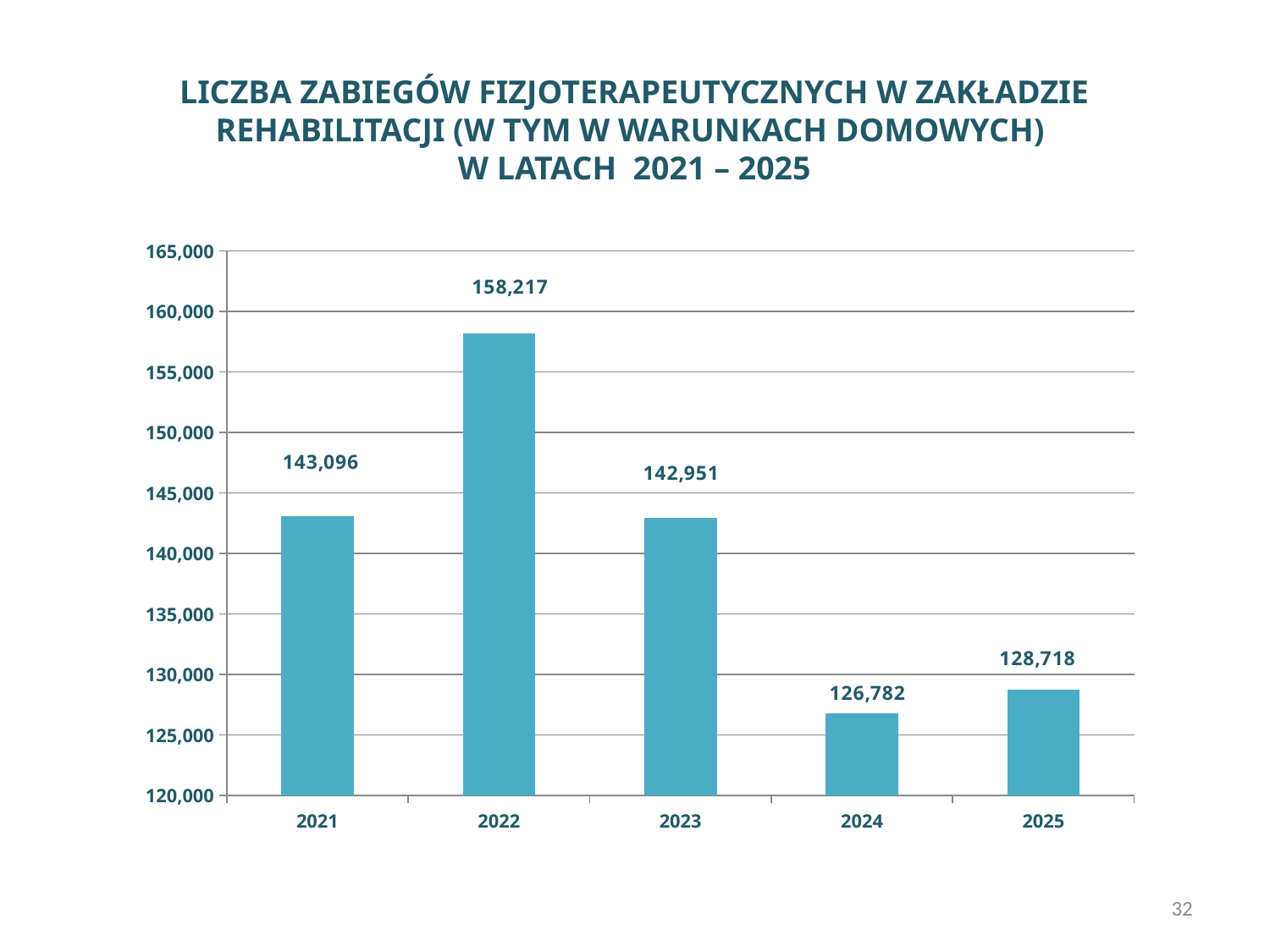
How many years are shown on the x axis? 5 What is the value for 2024? 126,782 Which year has the highest value? 2022 What is the difference between the values for 2025 and 2024? 1,936 What is the value for 2021? 143,096 Do the values rise or fall from 2022 to 2024? fall Is the value for 2022 greater or less than 155,000? greater Which is larger, the value for 2024 or the value for 2025? 2025 What is the difference between the values for 2022 and 2021? 15,121 What kind of chart is shown on the slide? bar chart What is the value for 2022? 158,217 Which year has the lowest value? 2024